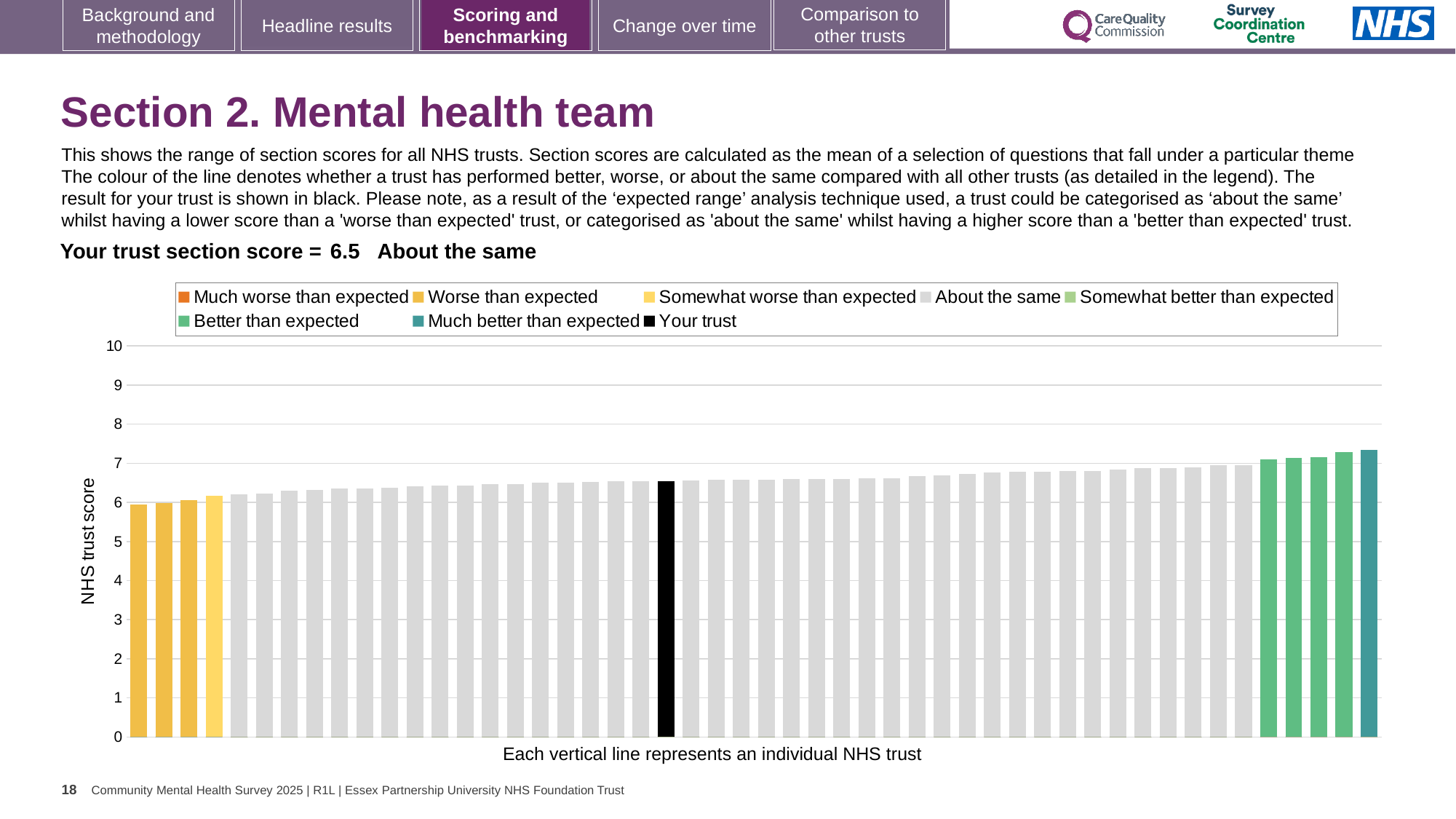
Which legend category does the highest bar belong to? Much better than expected Do the bar values rise or fall from left to right along the x axis? rise What kind of chart is shown on the slide? bar chart How many entries does the chart legend list? 8 How many bars are coloured as 'Worse than expected'? 3 Is the value of the rightmost bar greater or less than 8? less What is the label on the vertical axis of the chart? NHS trust score How many bars are coloured as 'Much better than expected'? 1 What is the section score for your trust (the black bar)? 6.5 Is the value of the leftmost bar greater or less than 5? greater Is the value for your trust (the black bar) greater or less than 7? less Which is larger, the rightmost bar or the leftmost bar? the rightmost bar